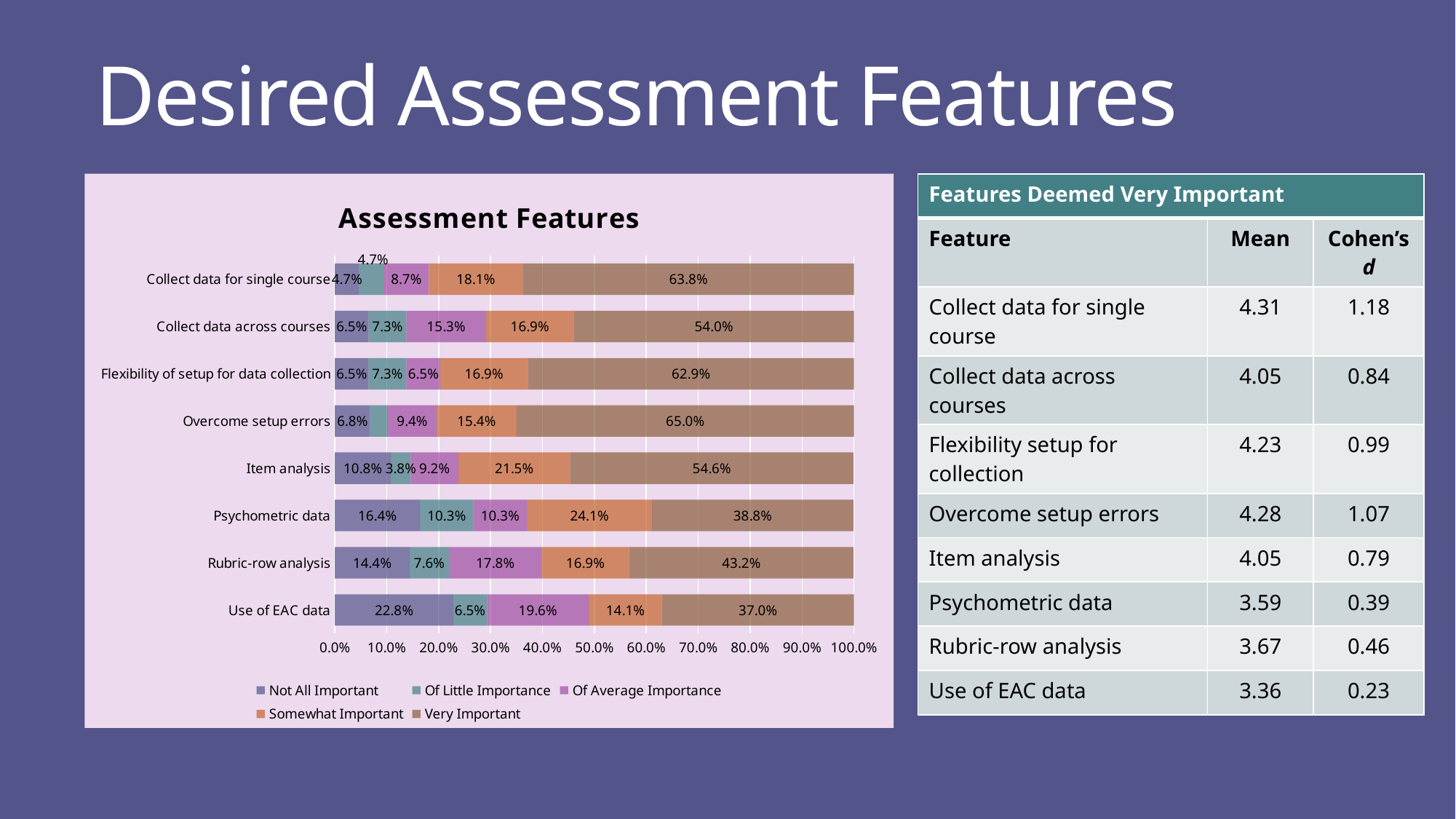
What kind of chart is the "Assessment Features" chart? Stacked bar chart In the "Assessment Features" chart, which feature has the lowest "Very Important" value? Use of EAC data In the "Assessment Features" chart, what is the "Not All Important" value for "Use of EAC data"? 22.8% How many features (categories) are plotted in the "Assessment Features" chart? 8 How many series does the legend of the "Assessment Features" chart list? 5 In the "Assessment Features" chart, which feature has the highest "Not All Important" value? Use of EAC data In the "Assessment Features" chart, which has the larger "Very Important" value: "Rubric-row analysis" or "Psychometric data"? Rubric-row analysis In the "Assessment Features" chart, what is the "Somewhat Important" value for "Psychometric data"? 24.1% In the "Assessment Features" chart, which feature has the highest "Very Important" value? Overcome setup errors In the "Assessment Features" chart, what is the difference in percentage points between the "Very Important" values for "Collect data for single course" and "Use of EAC data"? 26.8 percentage points In the "Assessment Features" chart, what is the "Very Important" value for "Collect data for single course"? 63.8% In the "Assessment Features" chart, which legend entry is shown in orange? Somewhat Important